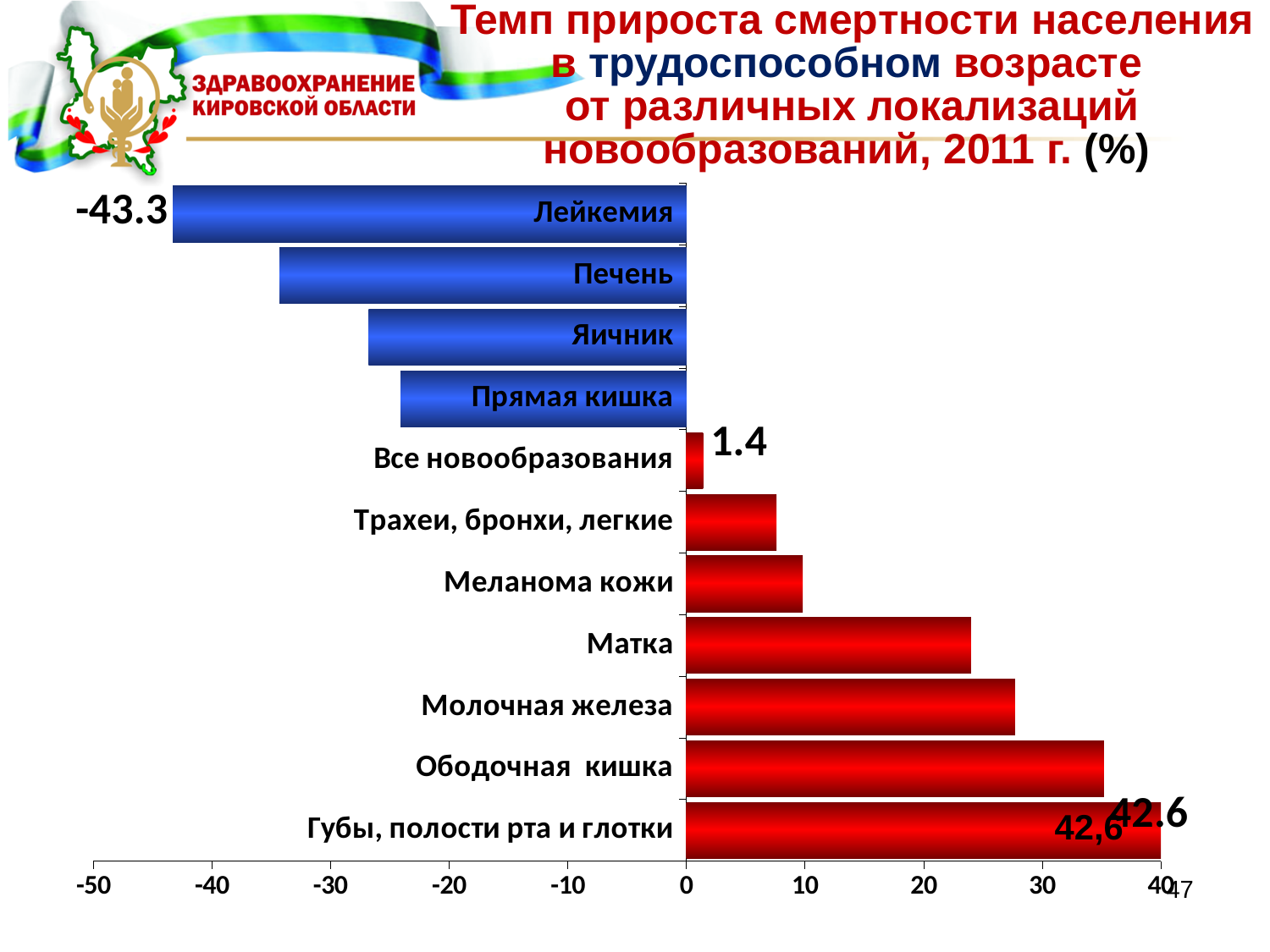
Which is larger, the value for Ободочная кишка or for Молочная железа? Ободочная кишка What is the difference between the values for Губы, полости рта и глотки and Лейкемия? 85.9 What is the value for Лейкемия? -43.3 How many categories are shown in the chart? 11 Is the value for Трахеи, бронхи, легкие greater or less than 10? less Which category has the highest value? Губы, полости рта и глотки Is the value for Матка greater or less than 20? greater What kind of chart is shown on the slide? bar chart Which category has the lowest value? Лейкемия Is the value for Печень greater or less than -30? less What is the value for Все новообразования? 1.4 What is the value for Губы, полости рта и глотки? 42.6